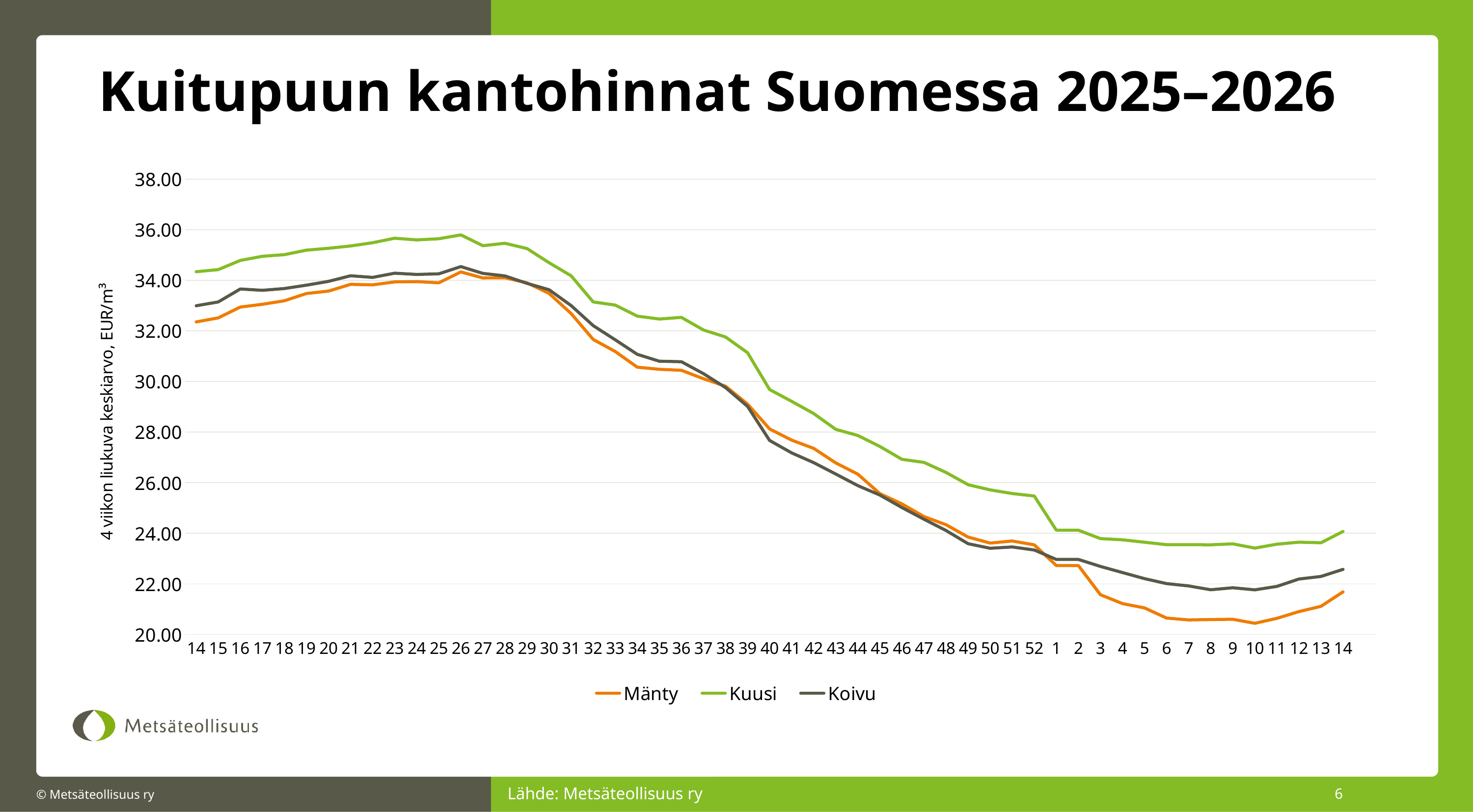
How many series does the legend list? 3 Is the value for Kuusi at week 26 greater or less than 34.00? greater Is the value for Koivu at week 40 greater or less than 30.00? less At week 14 (the first point on the x axis), which is higher, Kuusi or Mänty? Kuusi What is the title of the chart? Kuitupuun kantohinnat Suomessa 2025–2026 Is the value for Kuusi at week 52 greater or less than 24.00? greater Does the Mänty line rise or fall between week 30 and week 10? fall Which series is drawn in green? Kuusi At week 10, which is higher, Koivu or Mänty? Koivu Which series has the highest value at week 30? Kuusi What kind of chart is shown on the slide? line chart